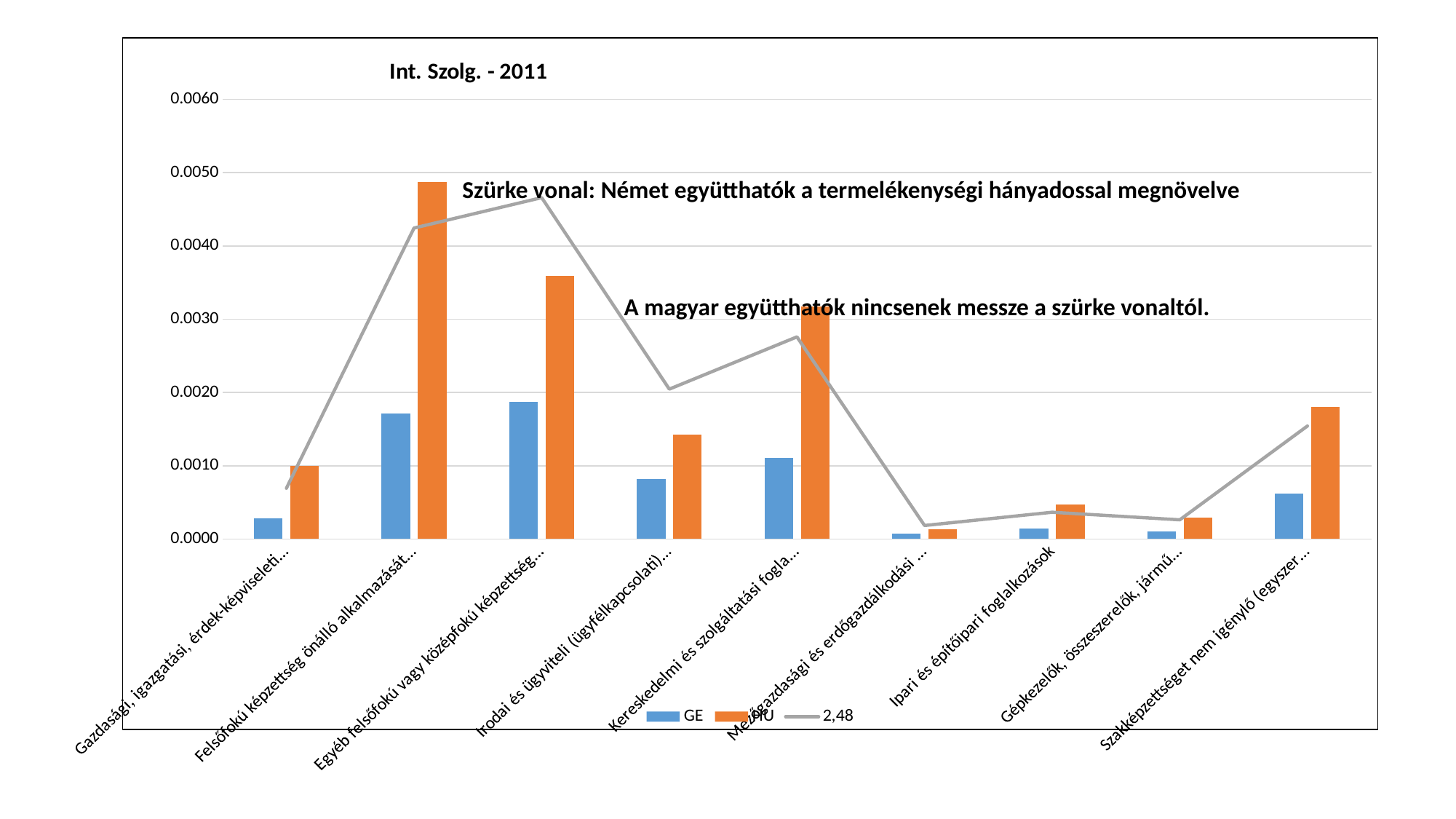
How many categories are shown on the x axis of the chart? 9 How many entries does the chart legend list? 3 For Irodai és ügyviteli (ügyfélkapcsolati)..., which series has the larger value, GE or HU? HU Which category has the lowest HU value? Mezőgazdasági és erdőgazdálkodási ... What kind of chart is shown on the slide? bar and line chart Is the GE value for Egyéb felsőfokú vagy középfokú képzettség... greater or less than 0.0020? less What is the title of the chart? Int. Szolg. - 2011 Is the HU value for Felsőfokú képzettség önálló alkalmazását... greater or less than 0.0040? greater What is the legend label of the grey line in the chart? 2,48 Which category has the highest GE value? Egyéb felsőfokú vagy középfokú képzettség... Which category has the highest HU value? Felsőfokú képzettség önálló alkalmazását... Is the HU value for Ipari és építőipari foglalkozások greater or less than 0.0010? less